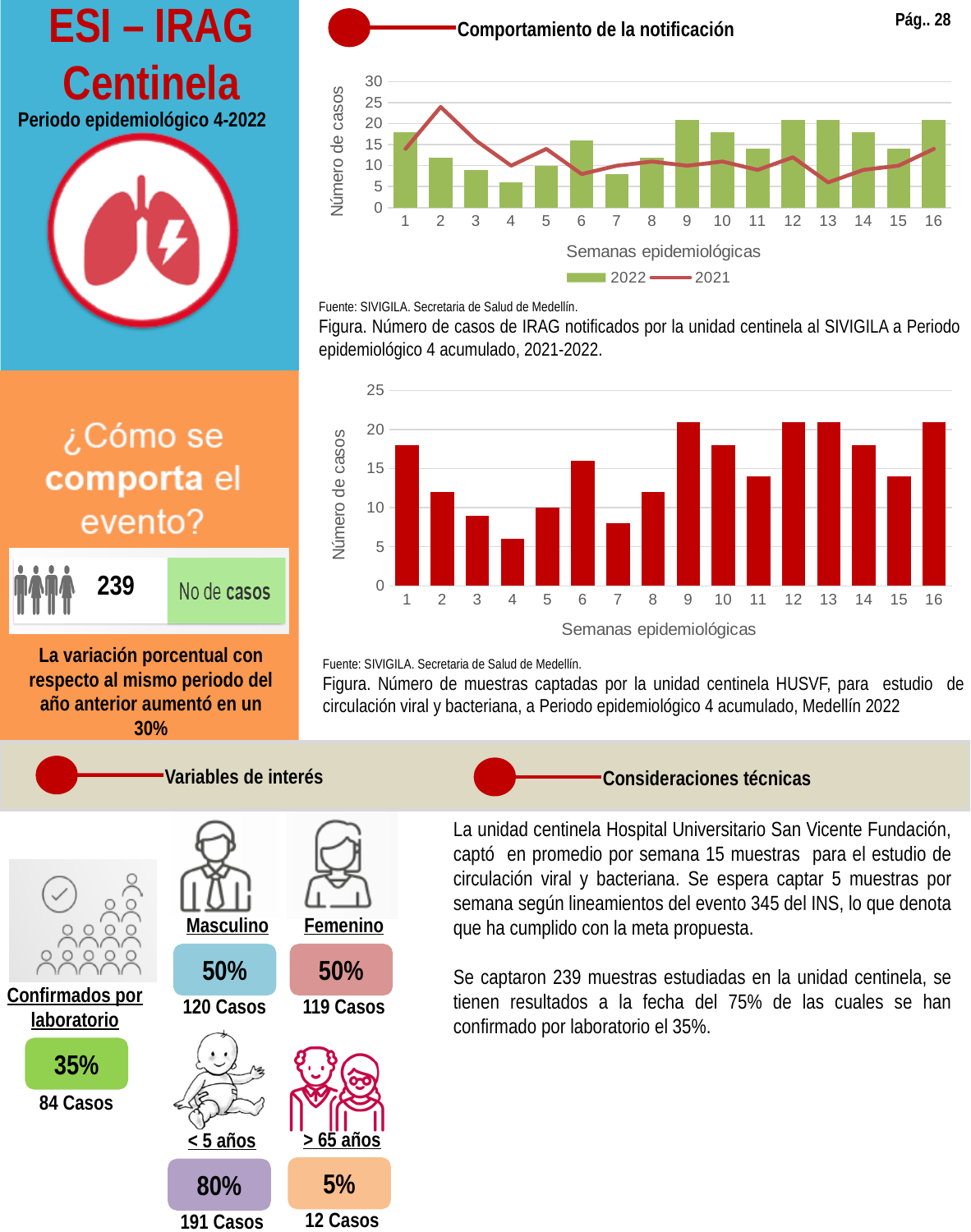
In the top chart, which epidemiological week has the lowest 2022 bar? 4 In the top chart (Comportamiento de la notificación), how many series does the legend list? 2 In the top chart, how many epidemiological weeks are shown on the x axis? 16 In the bottom chart, which has the larger value, week 9 or week 11? week 9 In the top chart, is the 2022 value for week 4 greater or less than 10? less In the top chart, is the 2022 value for week 9 greater or less than 20? greater In the top chart, which has the larger 2022 value, week 1 or week 3? week 1 In the top chart, in which week does the 2021 line reach its highest point? 2 In the bottom chart, which epidemiological week has the lowest bar? 4 In the bottom chart, is the value for week 7 greater or less than 10? less In the top chart, what are the two entries in the legend? 2022 and 2021 What kind of chart is the bottom chart (Número de muestras captadas)? bar chart